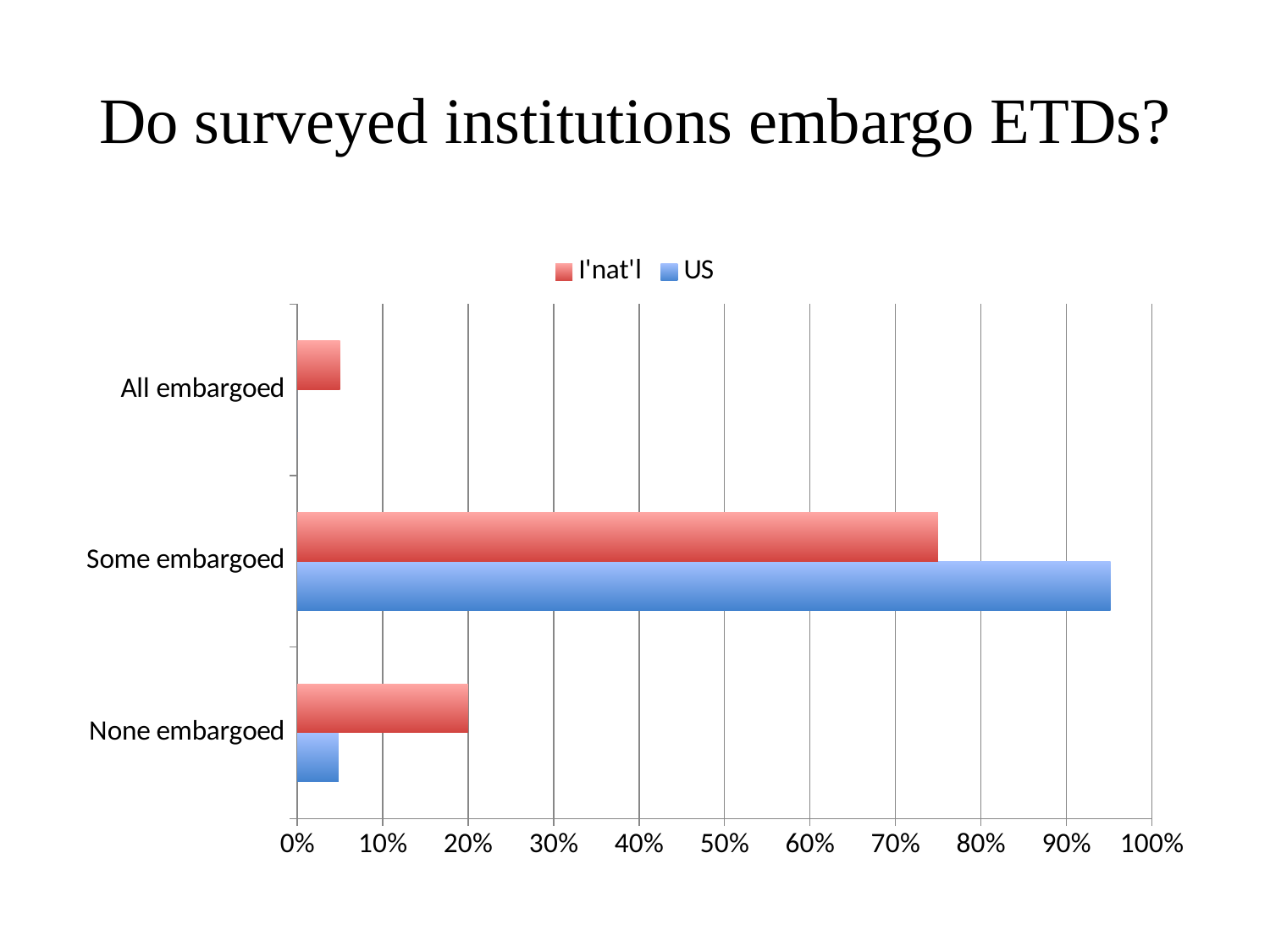
How many series does the legend list? 2 Which colour represents the US series in the chart? blue Is the I'nat'l value for Some embargoed greater or less than 80%? less For Some embargoed, which series has the larger value, I'nat'l or US? US Which category has the highest value for the US series? Some embargoed For None embargoed, which series has the larger value, I'nat'l or US? I'nat'l Is the I'nat'l value for All embargoed greater or less than 10%? less Is the US value for Some embargoed greater or less than 90%? greater Which category has the highest value for the I'nat'l series? Some embargoed How many categories are shown on the vertical axis? 3 What kind of chart is shown on the slide? bar chart